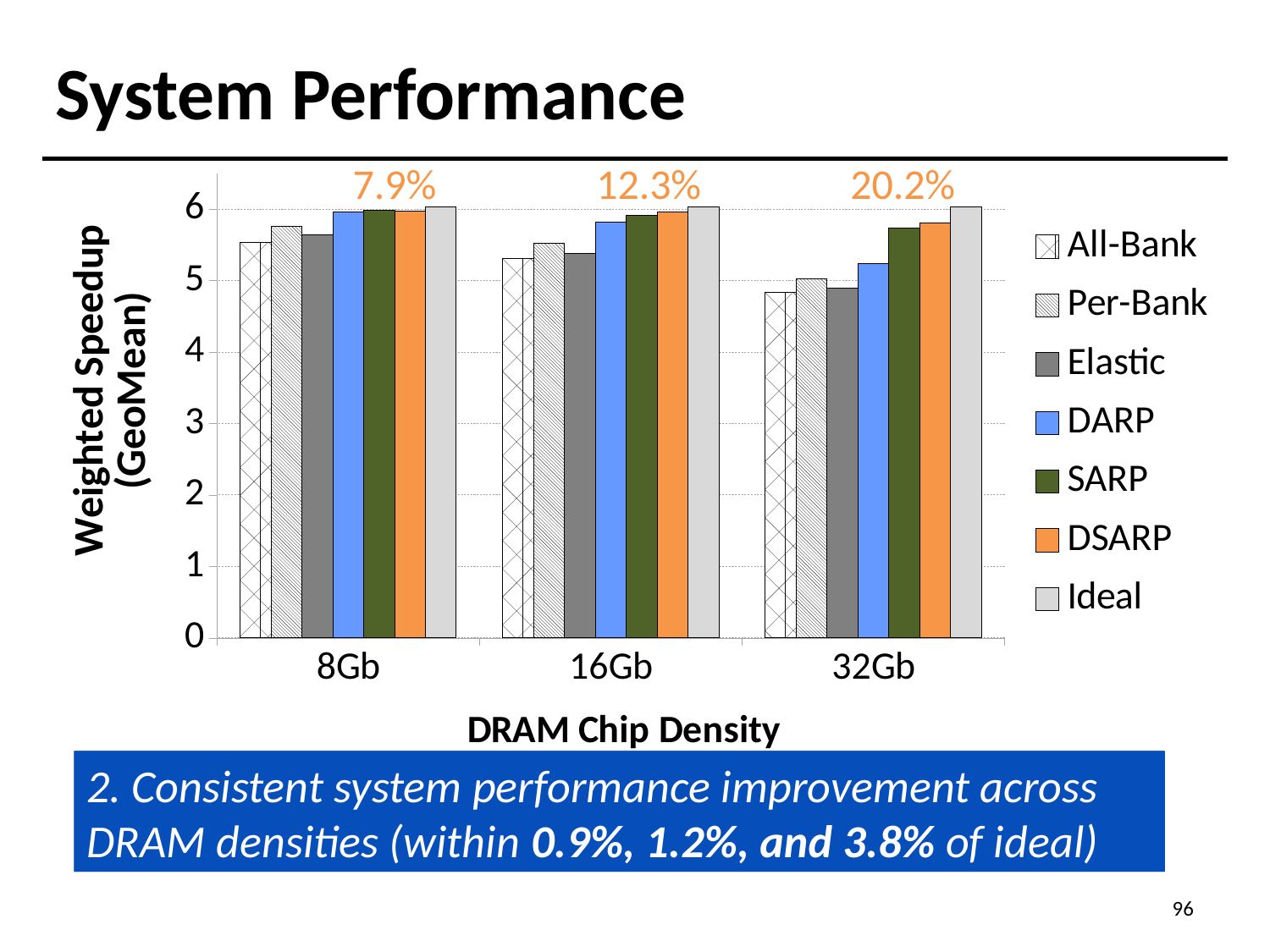
Is the value for All-Bank at 8Gb greater or less than 5? greater At 32Gb, which is larger, Ideal or All-Bank? Ideal Is the value for DARP at 32Gb greater or less than 5? greater What percentage is printed above the 32Gb group of bars? 20.2% Which series has the highest weighted speedup at 32Gb? Ideal How many DRAM chip density categories are shown on the x axis? 3 Do the All-Bank values rise or fall as DRAM chip density increases from 8Gb to 32Gb? fall Is the value for Elastic at 32Gb greater or less than 5? less How many series does the legend list? 7 What kind of chart is shown on the slide? bar chart At 16Gb, which is larger, DARP or Elastic? DARP